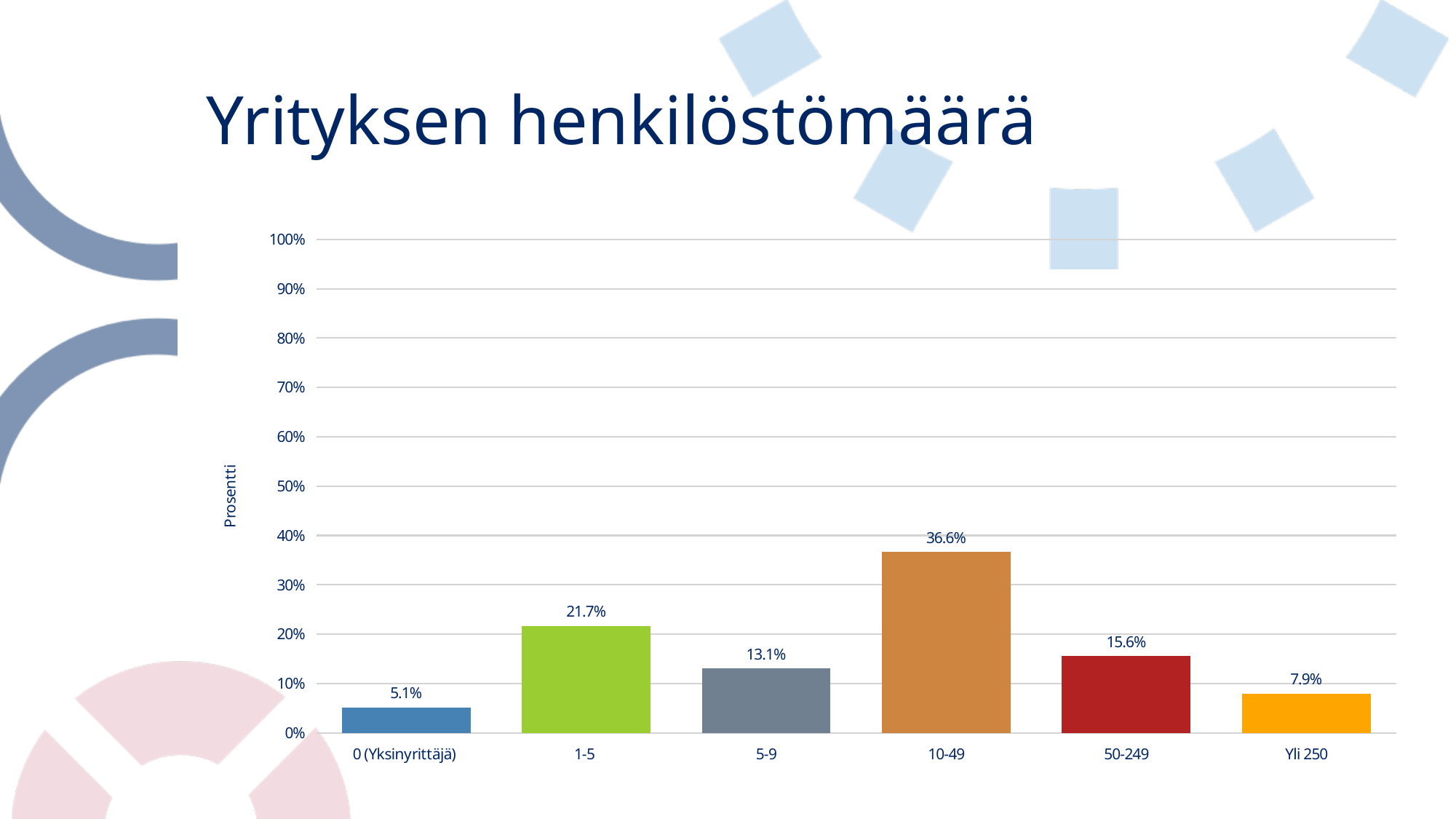
What is the difference between the values for 1-5 and 5-9? 8.6% What is the value for the 0 (Yksinyrittäjä) category? 5.1% What is the value for the 10-49 category? 36.6% What kind of chart is shown on the slide? bar chart What is the difference between the values for 10-49 and 50-249? 21.0% How many categories are shown on the x axis? 6 Which is larger, the value for 50-249 or the value for 5-9? 50-249 Is the value for 1-5 greater or less than 20%? greater What is the label of the vertical axis? Prosentti Which category has the lowest value? 0 (Yksinyrittäjä) What is the value for the Yli 250 category? 7.9% Which category has the highest value? 10-49